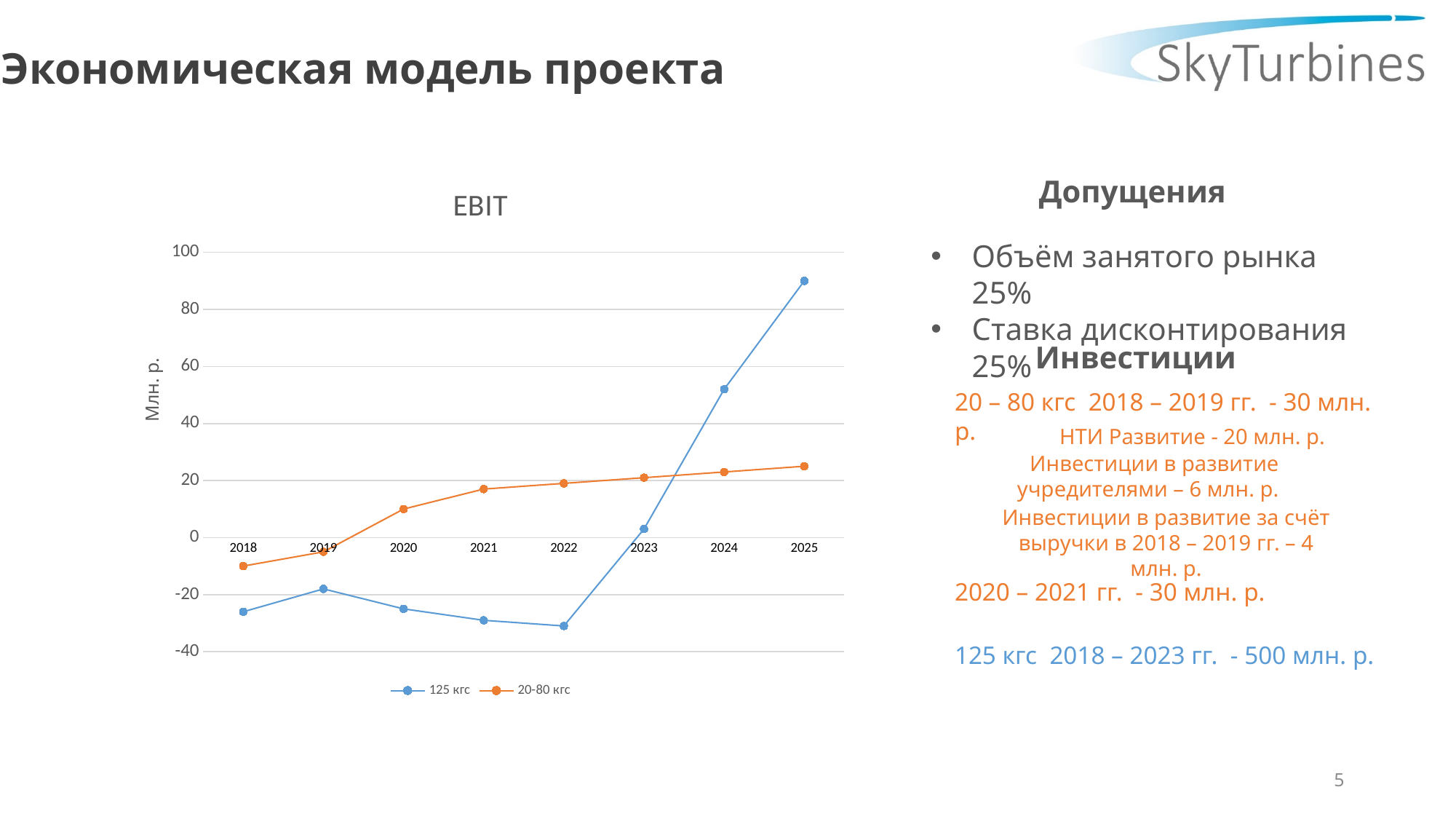
Does the 20-80 кгс series rise or fall from 2018 to 2025? rise What kind of chart is shown on the slide? line chart In which year does the 125 кгс series reach its highest value? 2025 How many years are plotted along the x axis of the EBIT chart? 8 In which year does the 20-80 кгс series have its lowest value? 2018 How many series does the legend of the EBIT chart list? 2 What is the label on the vertical axis of the EBIT chart? Млн. р. Is the value for 20-80 кгс in 2025 greater or less than 40? less In 2021, which series has the higher value, 125 кгс or 20-80 кгс? 20-80 кгс In 2024, which series has the higher value, 125 кгс or 20-80 кгс? 125 кгс Is the value for 125 кгс in 2018 greater or less than -20? less Is the value for 125 кгс in 2025 greater or less than 80? greater